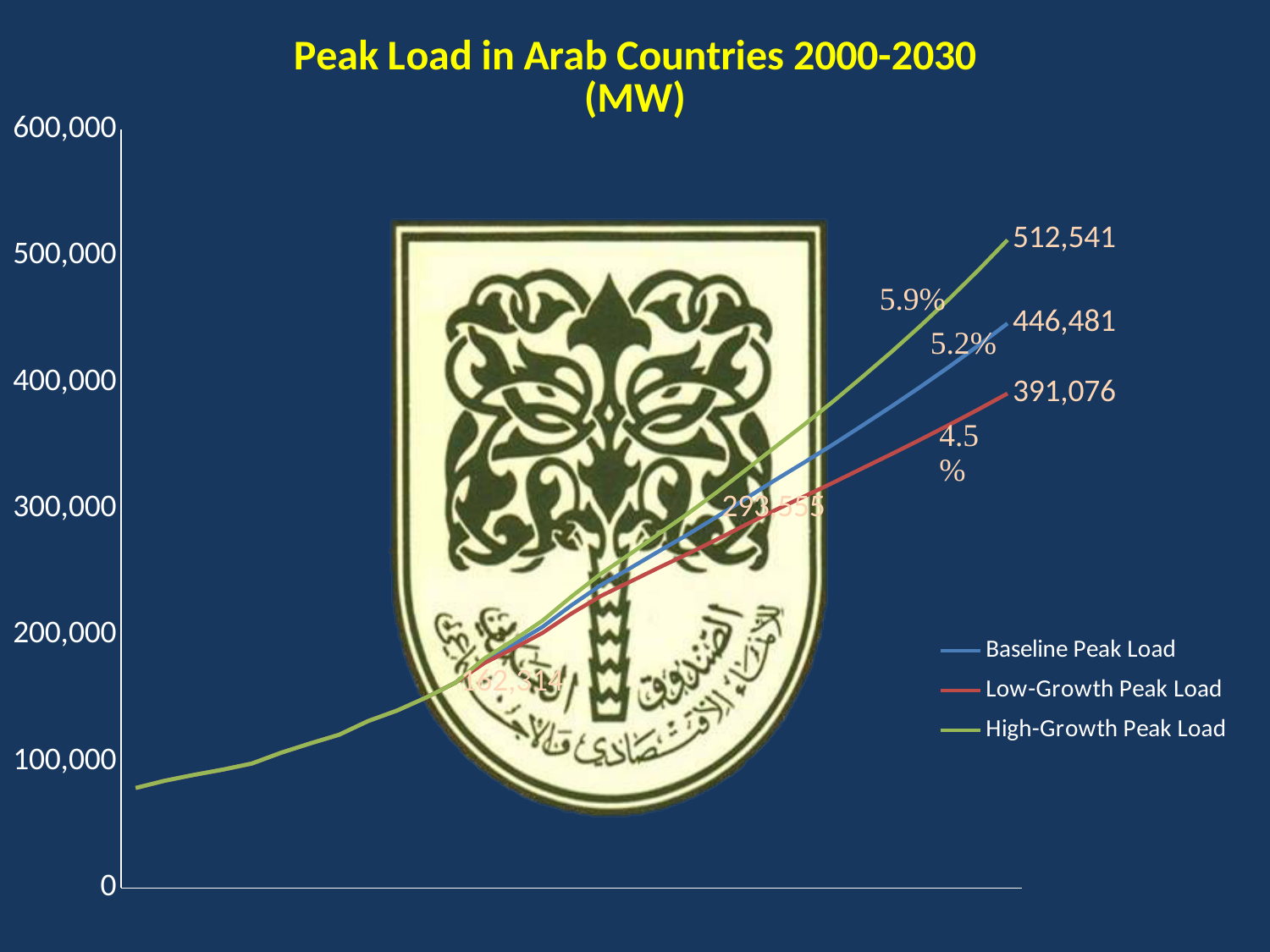
Is the final value of the Baseline Peak Load greater or less than 400,000? greater Which series ends at the lowest value at the right end of the chart? Low-Growth Peak Load Do the peak load values rise or fall over time along the x axis? Rise What is the difference between the final High-Growth Peak Load value and the final Low-Growth Peak Load value? 121,465 What is the final value shown for the Low-Growth Peak Load series? 391,076 What kind of chart is shown on the slide? Line chart What is the difference between the final Baseline Peak Load value and the final Low-Growth Peak Load value? 55,405 How many series does the legend list? 3 Which is larger at the end of the chart, the Baseline Peak Load or the Low-Growth Peak Load? Baseline Peak Load What is the final value shown for the Baseline Peak Load series? 446,481 What is the final value shown for the High-Growth Peak Load series? 512,541 Which series ends at the highest value at the right end of the chart? High-Growth Peak Load